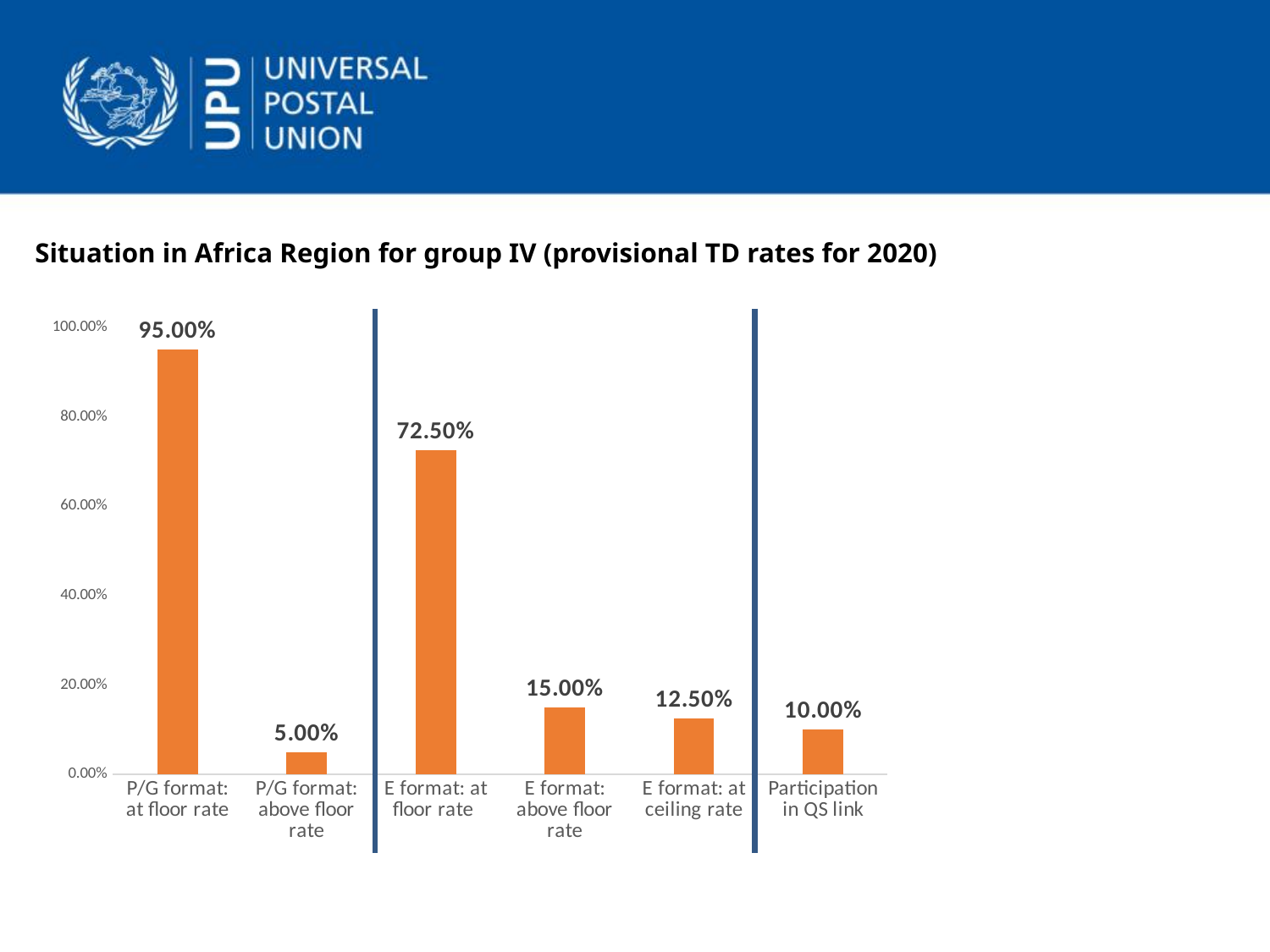
What is the difference between P/G format: at floor rate and E format: at floor rate? 22.50% What is the title of the chart? Situation in Africa Region for group IV (provisional TD rates for 2020) What is the difference between E format: above floor rate and E format: at ceiling rate? 2.50% Which is larger, E format: above floor rate or Participation in QS link? E format: above floor rate Which category has the lowest value? P/G format: above floor rate How many categories are shown on the x axis? 6 What kind of chart is shown on the slide? Bar chart What is the value for E format: at floor rate? 72.50% What is the value for E format: at ceiling rate? 12.50% Which category has the highest value? P/G format: at floor rate What is the value for P/G format: at floor rate? 95.00% What is the value for Participation in QS link? 10.00%